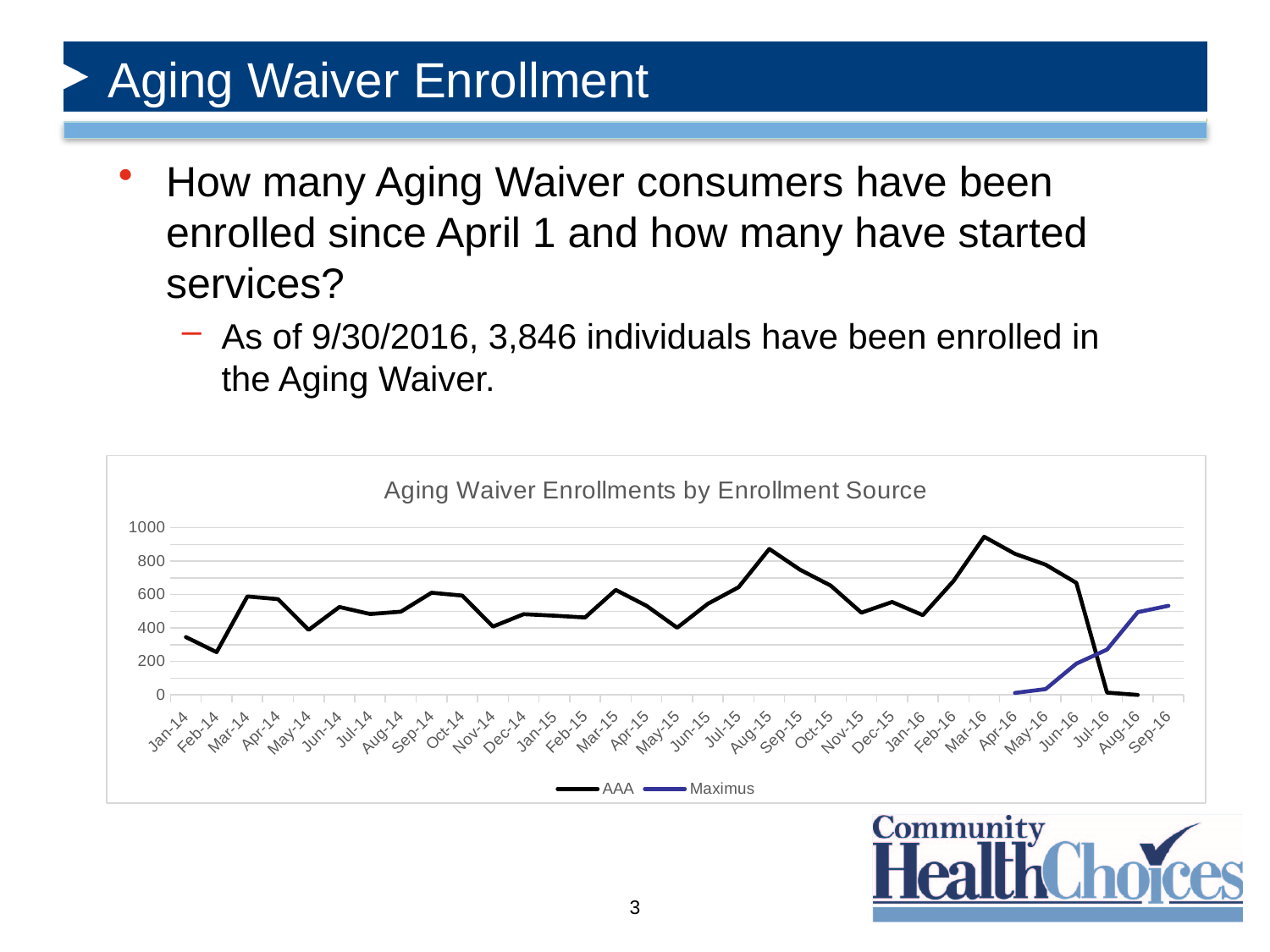
What kind of chart is shown on the slide? line chart In which month does the AAA series reach its highest value? Mar-16 Is the Maximus value for Apr-16 greater or less than 200? less How many months are shown along the x axis of the chart? 33 What is the title of the chart? Aging Waiver Enrollments by Enrollment Source Is the AAA value for Mar-16 greater or less than 800? greater Which series is drawn in black in the chart? AAA In Sep-16, which series has the larger value, AAA or Maximus? Maximus Is the AAA value for Feb-14 greater or less than 400? less Does the Maximus series rise or fall from Apr-16 to Sep-16? rise How many series does the legend of the chart list? 2